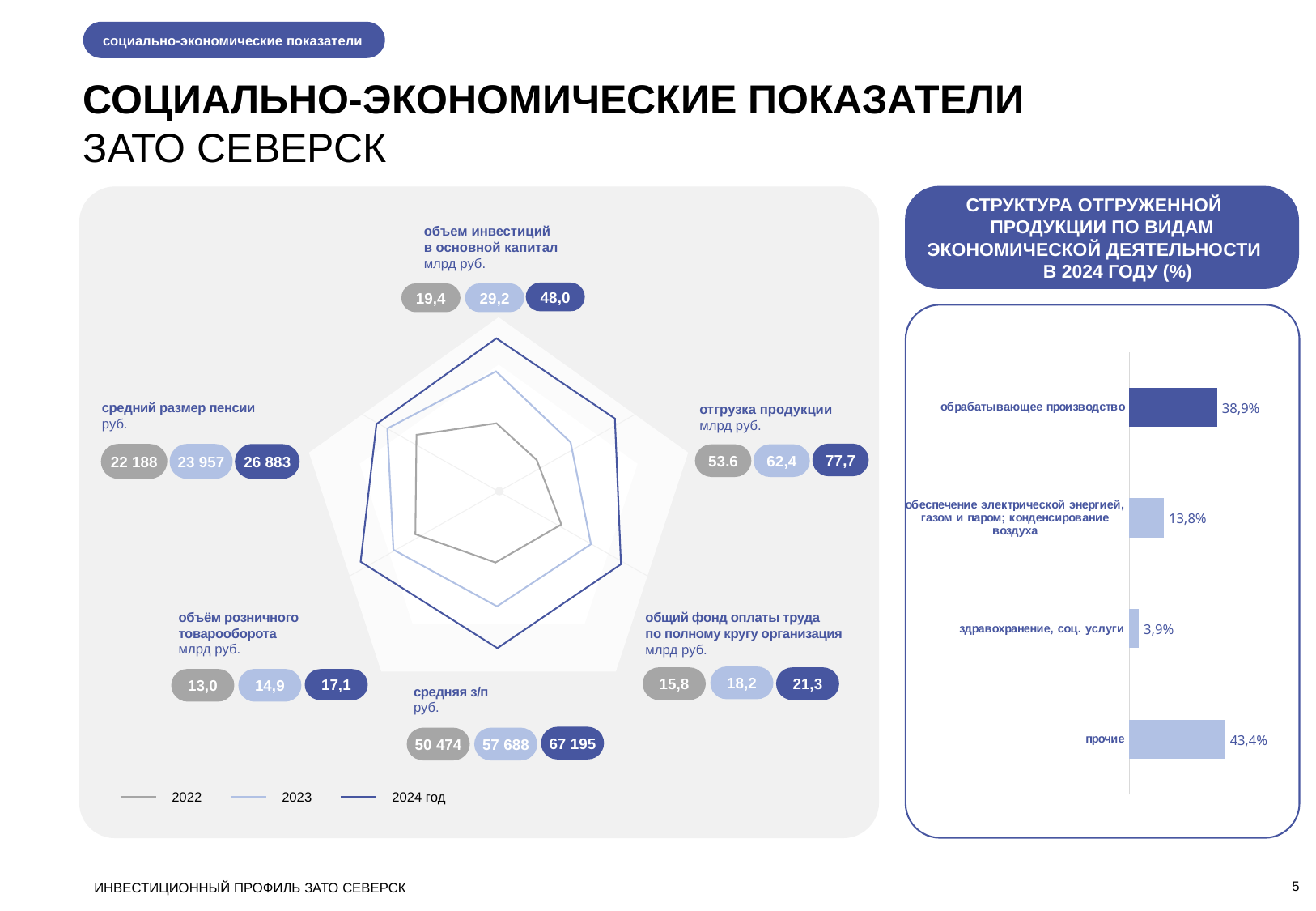
On the radar chart on the left, what is the value of 'объем инвестиций в основной капитал' for 2024? 48,0 On the bar chart on the right, what is the difference between 'прочие' and 'обрабатывающее производство'? 4,5% On the bar chart on the right, what is the value for 'обрабатывающее производство'? 38,9% What kind of chart is the chart on the right side of the slide? bar chart On the bar chart on the right, which category has the lowest value? здравоохранение, соц. услуги On the radar chart on the left, does 'объём розничного товарооборота' rise or fall from 2022 to 2024? rise On the radar chart on the left, which is larger: the 2023 value of 'средний размер пенсии' or the 2022 value? 2023 On the radar chart on the left, what is the value of 'средняя з/п' for 2022? 50 474 On the radar chart on the left, what is the difference between the 2024 and 2023 values of 'отгрузка продукции'? 15,3 On the bar chart on the right, which category has the highest value? прочие On the radar chart on the left, how many years does the legend list? 3 On the bar chart on the right, how many categories are shown? 4